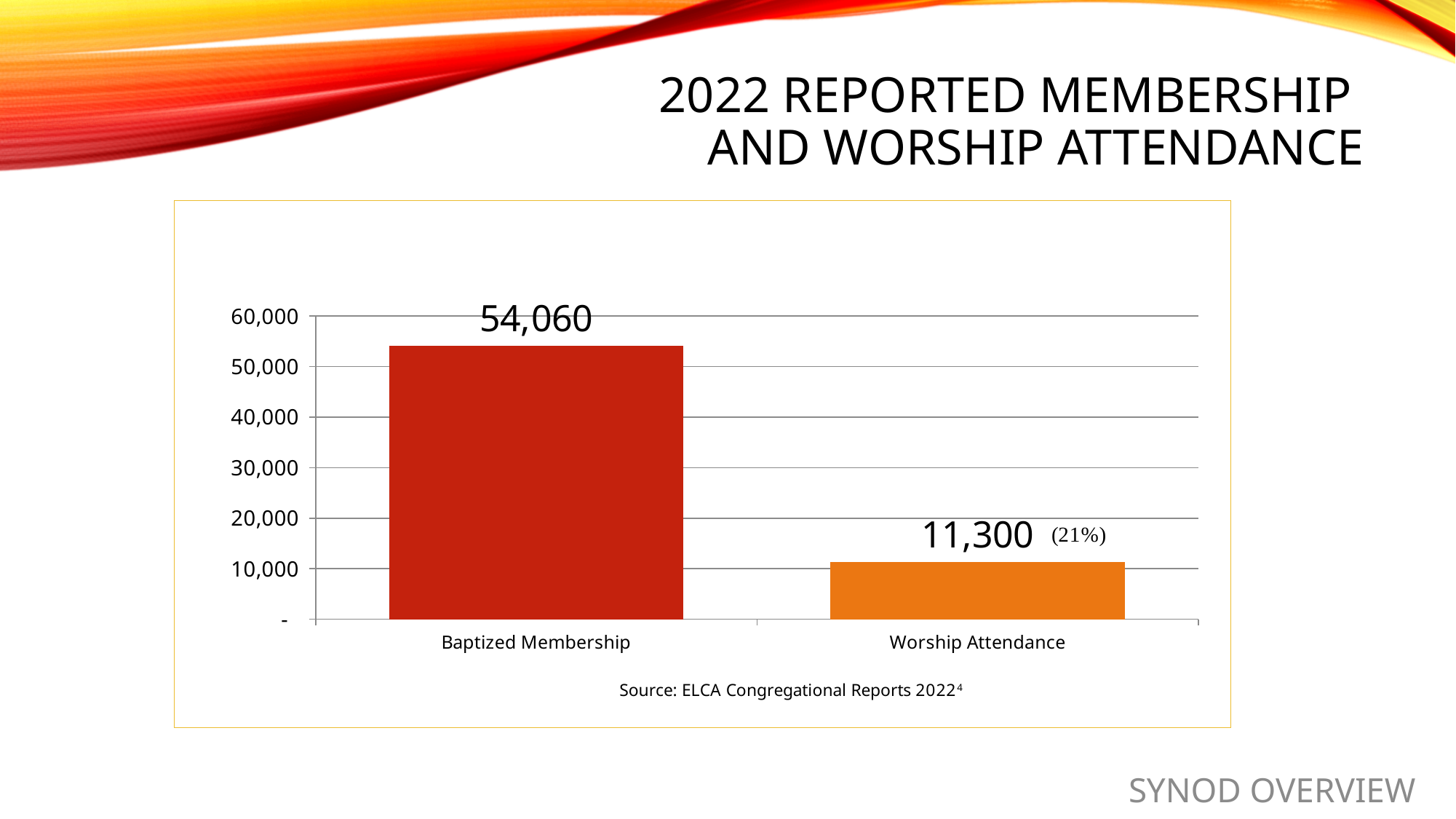
Which category has the highest value? Baptized Membership Is the value for Baptized Membership greater or less than 50,000? greater Which is larger, Baptized Membership or Worship Attendance? Baptized Membership What is the value for Worship Attendance? 11,300 What is the value for Baptized Membership? 54,060 What percentage is shown next to the Worship Attendance value? 21% What kind of chart is shown on the slide? Bar chart Which category has the lowest value? Worship Attendance What source is cited below the chart? ELCA Congregational Reports 2022 Is the value for Worship Attendance greater or less than 20,000? less What is the difference between Baptized Membership and Worship Attendance? 42,760 How many categories are shown on the chart? 2